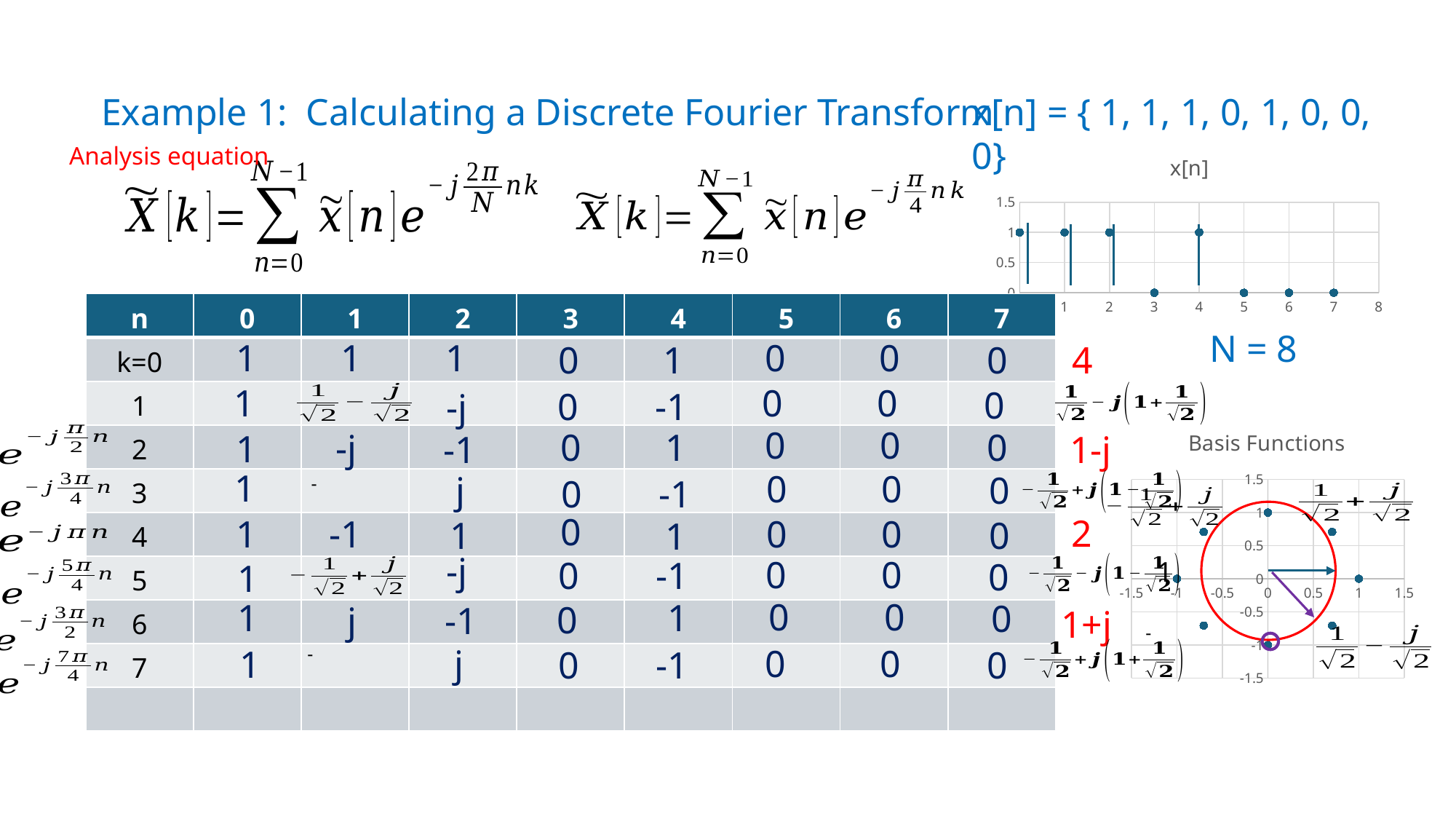
In the x[n] chart, what is the highest plotted value? 1 In the x[n] chart, which is larger, the value at n = 2 or the value at n = 3? n = 2 In the x[n] chart, what is the value at n = 3? 0 In the x[n] chart, what is the value at n = 7? 0 How many data points are plotted in the x[n] chart? 8 In the x[n] chart, is the value at n = 4 greater or less than 0.5? greater In the x[n] chart, what is the value at n = 4? 1 In the x[n] chart, what is the value at n = 0? 1 What is the title of the chart in the top right of the slide? x[n] In the x[n] chart, is the value at n = 5 greater or less than 0.5? less What kind of chart is the Basis Functions chart? scatter chart